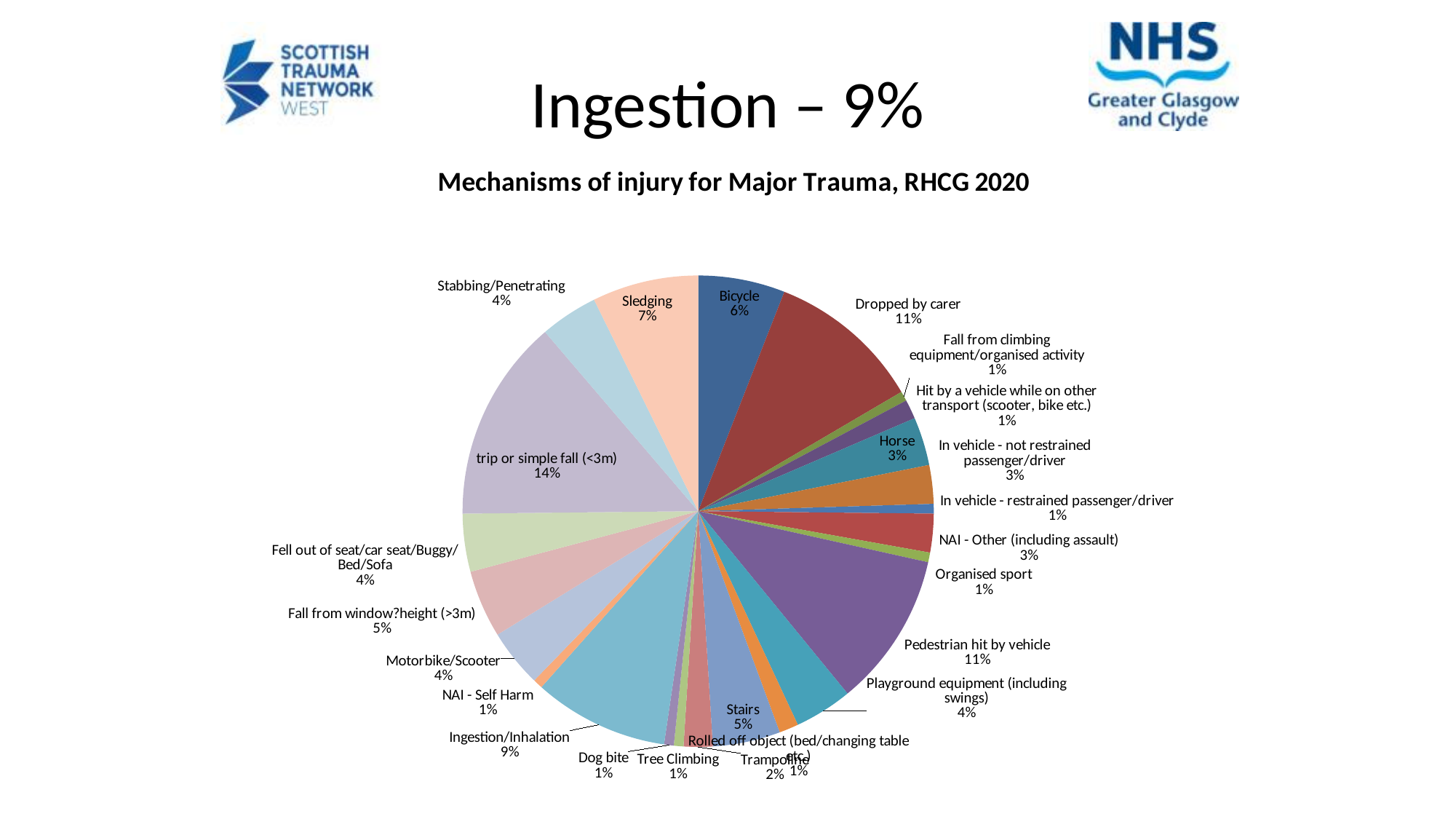
What percentage is shown for trip or simple fall (<3m)? 14% Which is larger, the share for Ingestion/Inhalation or the share for Sledging? Ingestion/Inhalation What percentage is shown for Dropped by carer? 11% What percentage is shown for Horse? 3% What percentage is shown for Stairs? 5% What is the difference in percentage points between trip or simple fall (<3m) and Sledging? 7 percentage points Which mechanism of injury has the largest slice of the pie? trip or simple fall (<3m) What is the title of the chart? Mechanisms of injury for Major Trauma, RHCG 2020 What percentage is shown for Pedestrian hit by vehicle? 11% What percentage is shown for Sledging? 7% What share of the pie does Ingestion/Inhalation represent? 9% What type of chart is shown on the slide? Pie chart